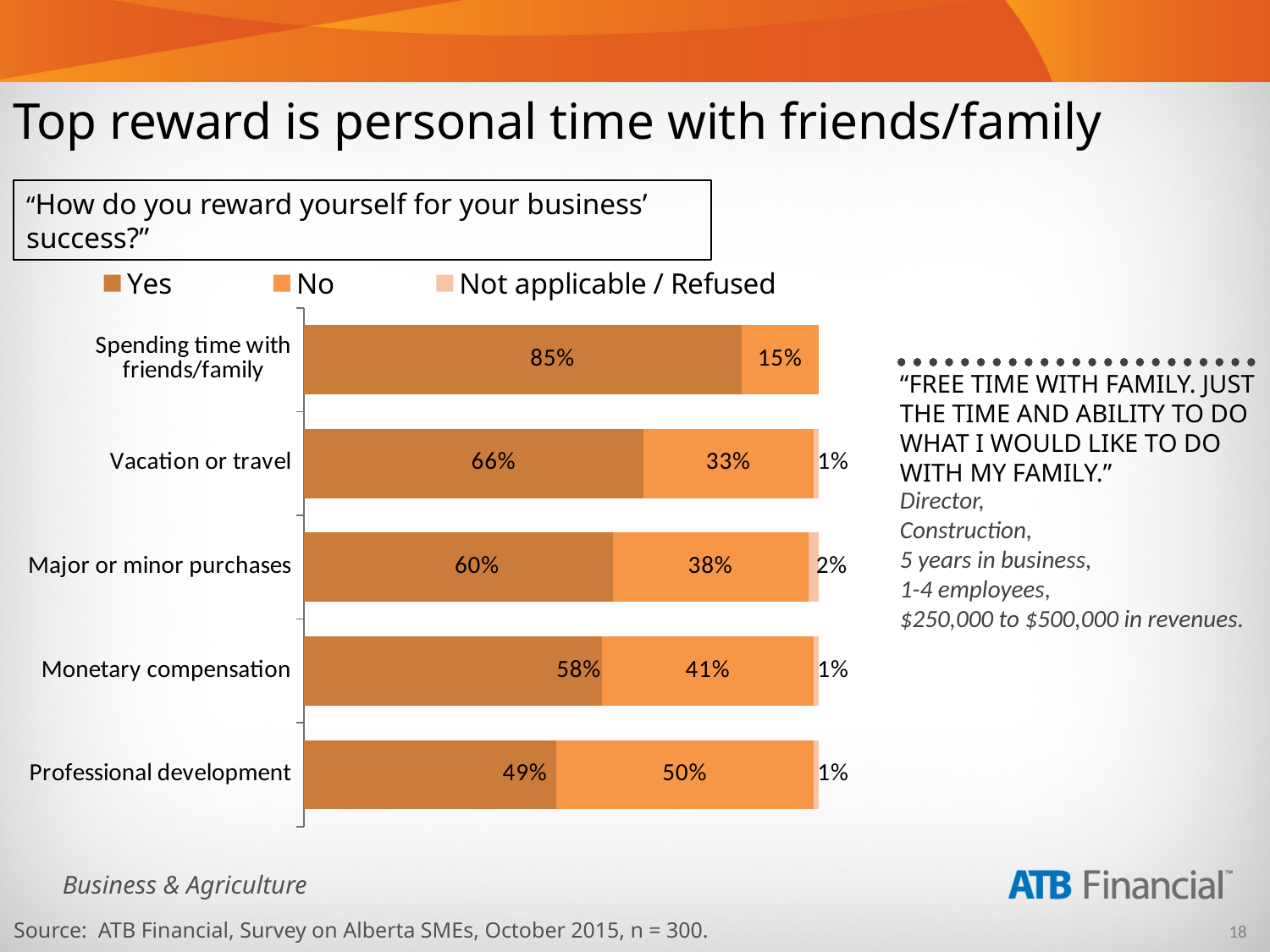
What is the difference between the Yes values for Vacation or travel and Monetary compensation? 8% How many series does the legend list? 3 How many categories are shown in the chart? 5 What kind of chart is shown on the slide? Stacked bar chart What percentage of respondents said Yes to spending time with friends/family as a reward? 85% What is the Not applicable / Refused value for Major or minor purchases? 2% Which category has the lowest Yes value? Professional development Which is larger: the No value for Professional development or the No value for Monetary compensation? Professional development What is the No value for Vacation or travel? 33% Which category has the highest Yes value? Spending time with friends/family What is the Yes value for Professional development? 49% What is the total of the Yes and No values for Major or minor purchases? 98%